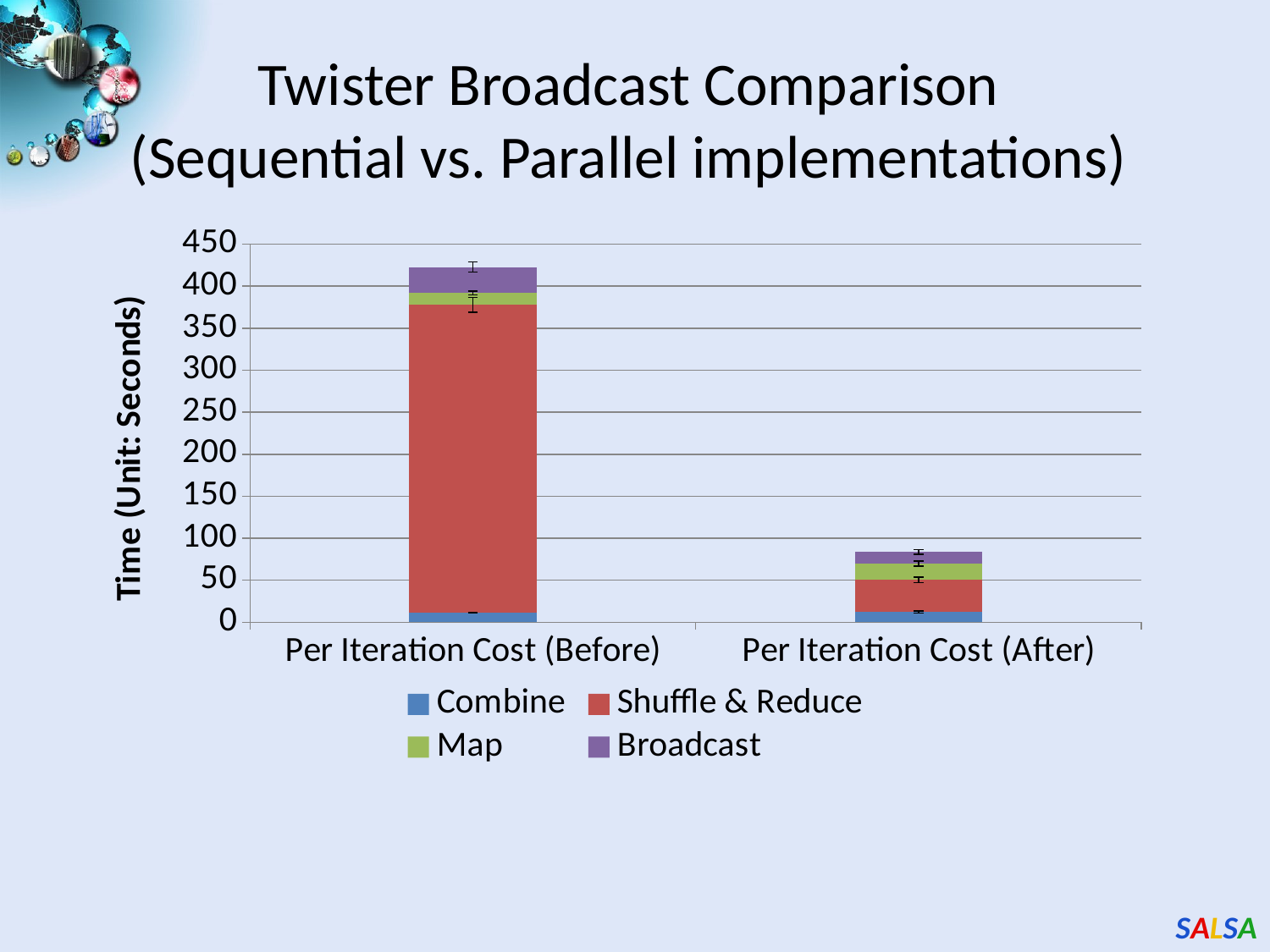
Is the total bar for Per Iteration Cost (Before) greater or less than 400? greater How many categories are shown on the x axis? 2 How many series does the legend list? 4 Which series is shown in purple in the legend? Broadcast Which series takes up the largest segment of the Per Iteration Cost (Before) bar? Shuffle & Reduce What is the label of the y axis? Time (Unit: Seconds) Is the Shuffle & Reduce segment for Per Iteration Cost (Before) greater or less than 300? greater Is the total bar for Per Iteration Cost (After) greater or less than 100? less Which category has the lowest total bar? Per Iteration Cost (After) Which category has the higher total bar, Per Iteration Cost (Before) or Per Iteration Cost (After)? Per Iteration Cost (Before) What kind of chart is shown on the slide? stacked bar chart Do the total bar values rise or fall from Per Iteration Cost (Before) to Per Iteration Cost (After)? fall